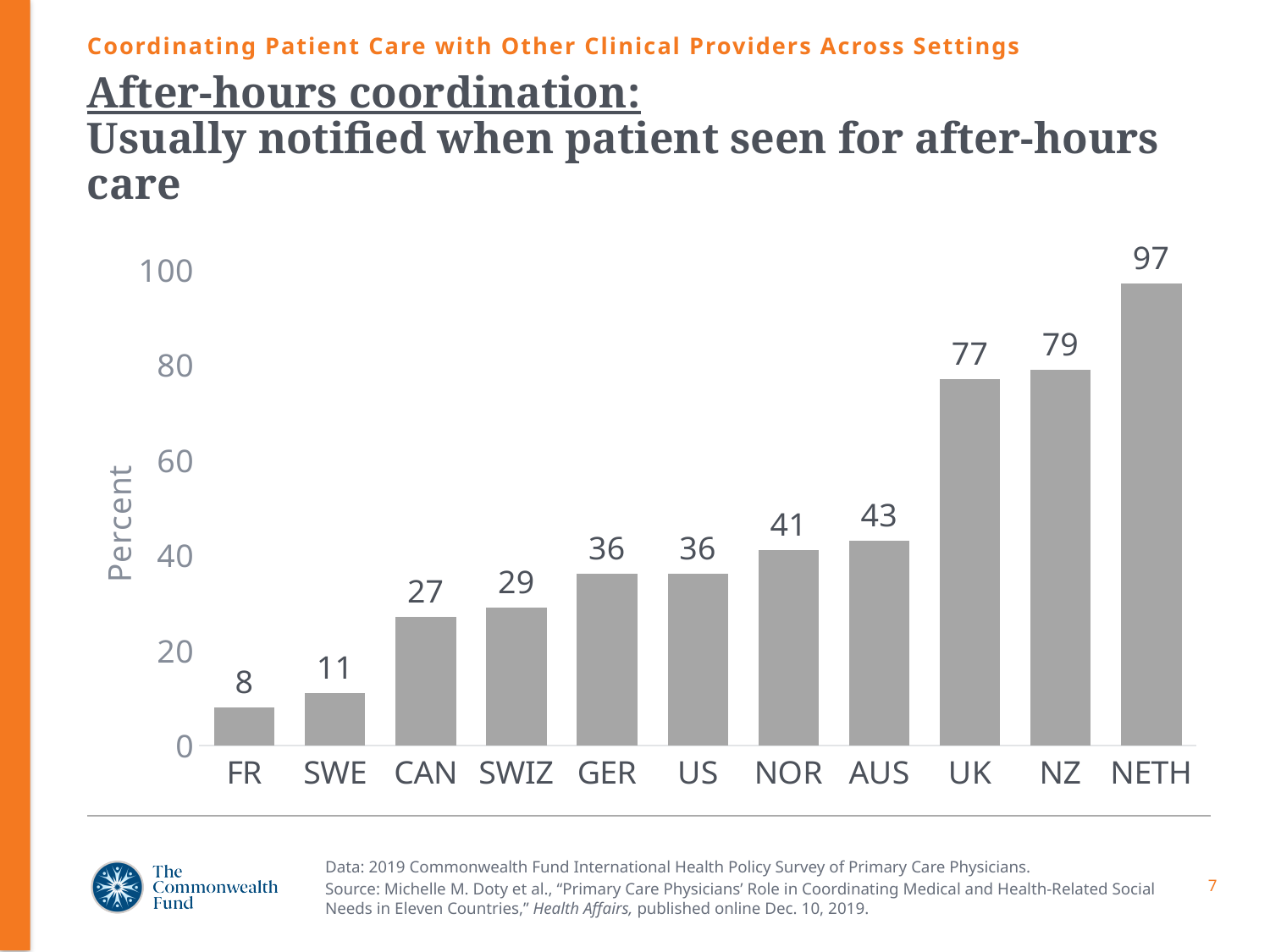
Do the values rise or fall from left to right along the x axis? rise What is the difference between the values for NETH and FR? 89 What is the value for NETH? 97 What is the difference between the values for NZ and UK? 2 Is the value for UK greater or less than 60? greater What is the value for SWE? 11 What kind of chart is shown? bar chart What is the value for NOR? 41 Which is larger, the value for AUS or the value for CAN? AUS Which country has the highest value? NETH Which country has the lowest value? FR How many countries are shown on the x axis? 11